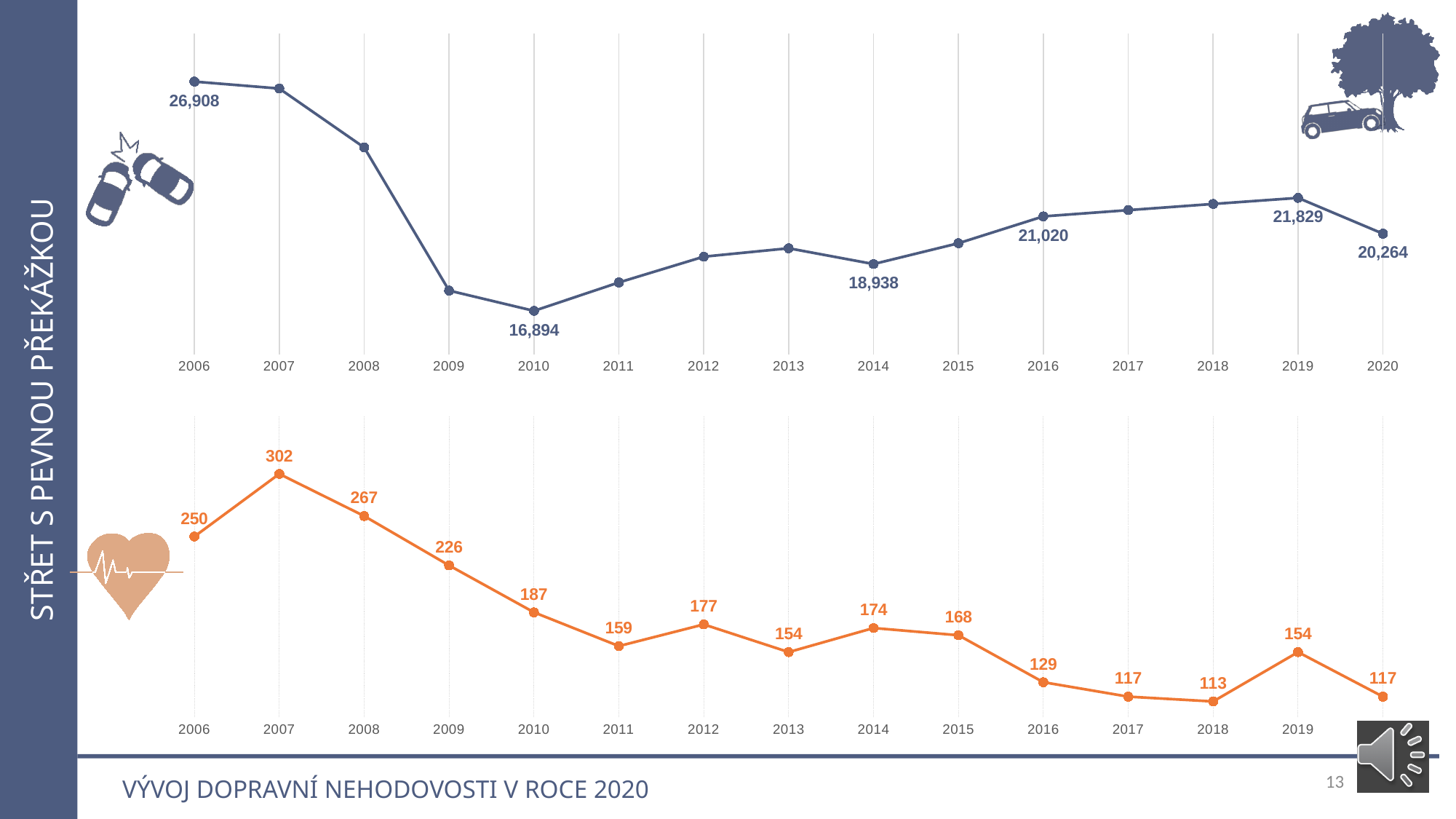
How many years are plotted in the bottom chart? 15 In the top chart, which year has the highest value? 2006 In the bottom chart, what is the value for 2007? 302 In the bottom chart, which year has the lowest value? 2018 In the top chart, what is the value for 2006? 26,908 What type of chart is the bottom chart? Line chart In the bottom chart, which is larger, the value for 2012 or the value for 2013? 2012 In the bottom chart, what is the difference between the values for 2006 and 2007? 52 In the top chart, what is the value for 2010? 16,894 In the top chart, which year has the lowest value? 2010 In the top chart, what is the difference between the values for 2019 and 2020? 1,565 In the top chart, what is the value for 2020? 20,264